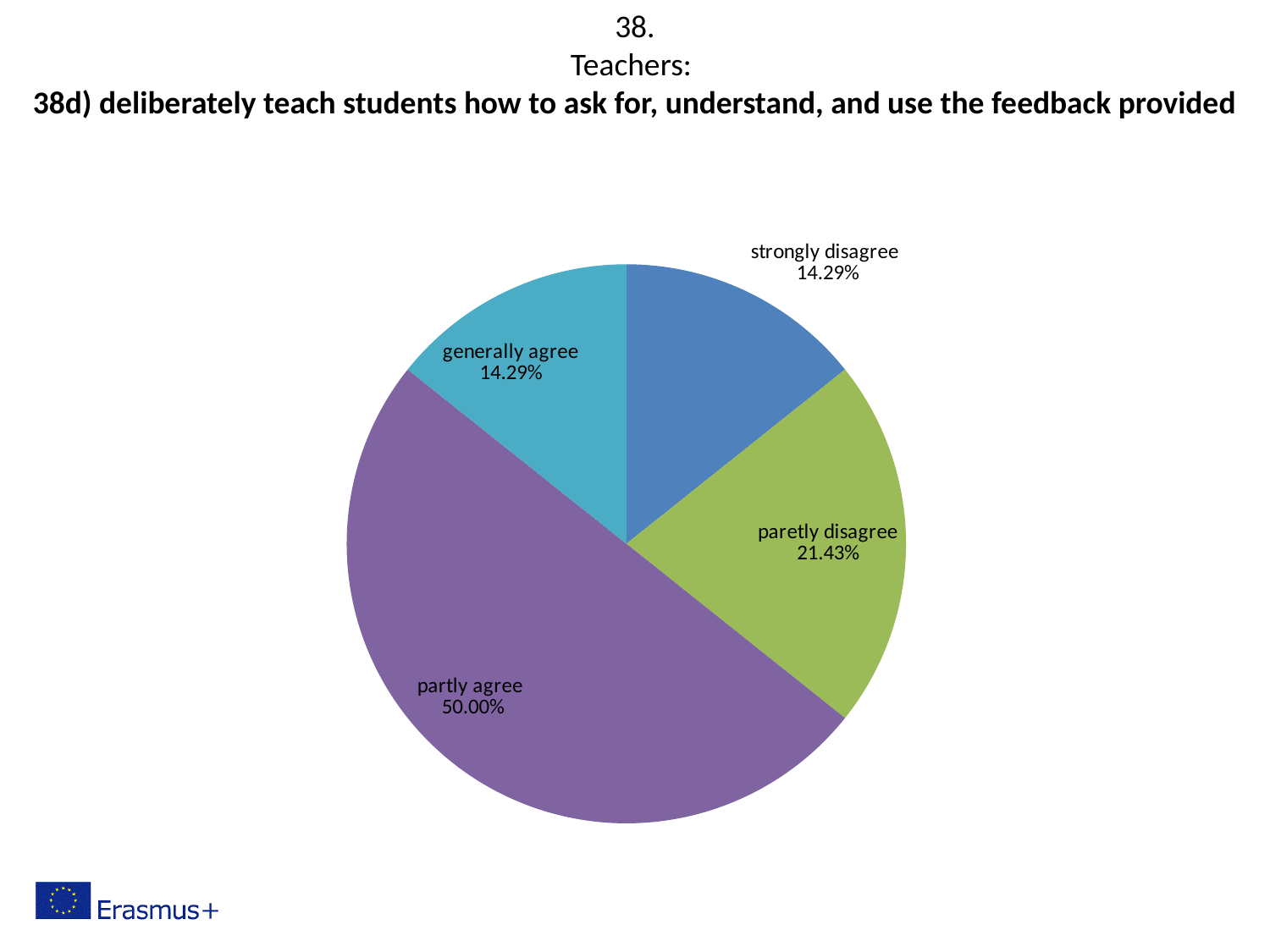
Which two slices have the same share of the pie? strongly disagree and generally agree What share of the pie is labelled "partly agree"? 50.00% Which is larger, the "paretly disagree" slice or the "strongly disagree" slice? paretly disagree What share of the pie is labelled "paretly disagree"? 21.43% What share of the pie is labelled "strongly disagree"? 14.29% What is the combined share of the "strongly disagree" and "paretly disagree" slices? 35.72% Which colour is the "partly agree" slice? purple Which slice of the pie is the largest? partly agree What kind of chart is shown on the slide? pie chart What is the difference in percentage points between the "partly agree" slice and the "paretly disagree" slice? 28.57% What share of the pie is labelled "generally agree"? 14.29% How many slices does the pie chart have? 4